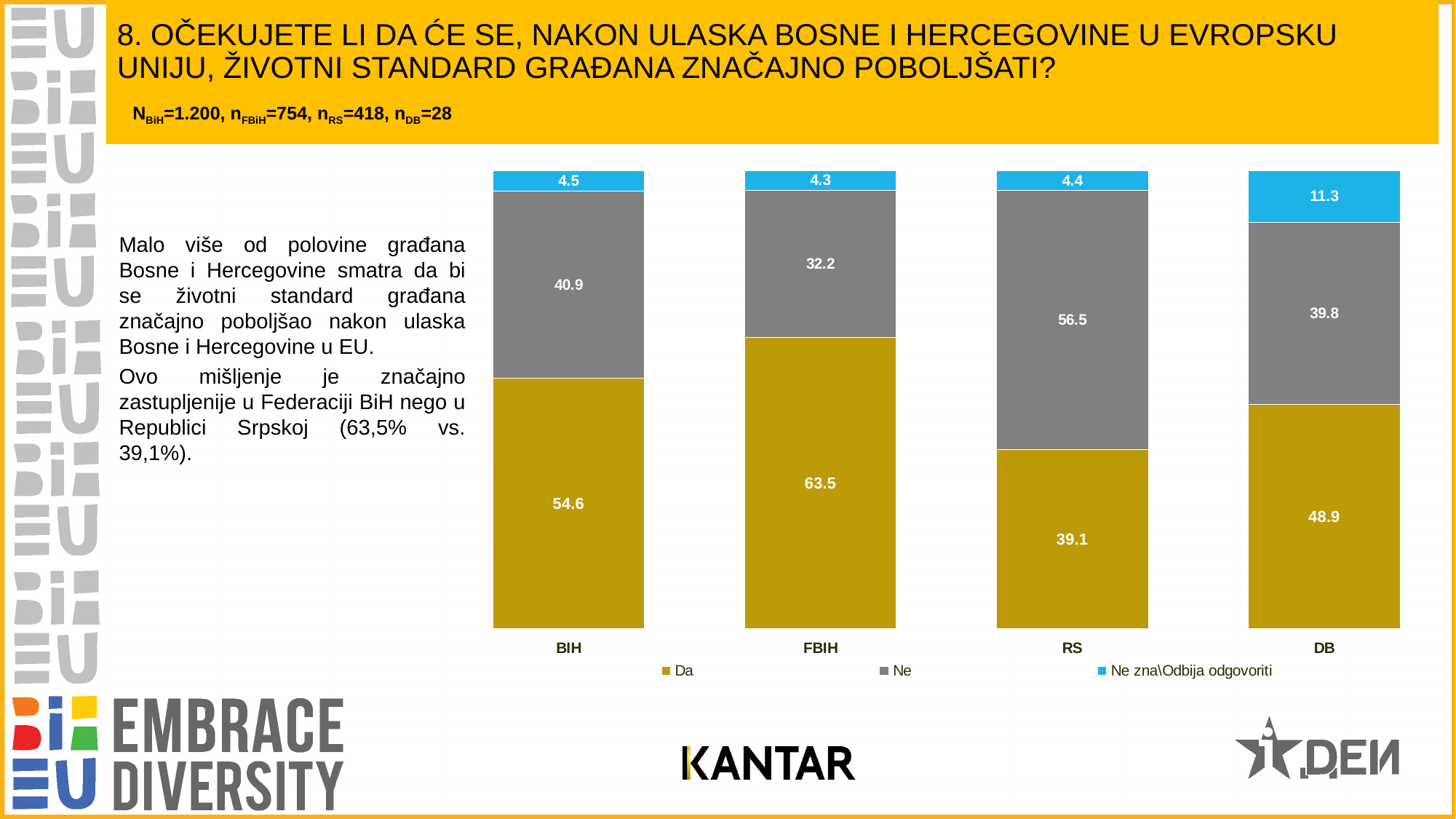
What is the value of "Da" for BIH? 54.6 What is the value of "Ne" for RS? 56.5 How many series does the legend list? 3 Which is larger, the "Ne" value for BIH or the "Ne" value for DB? BIH What is the value of "Ne zna\Odbija odgovoriti" for DB? 11.3 How many categories are shown on the x axis? 4 What is the value of "Da" for FBIH? 63.5 Which category has the lowest "Da" value? RS What is the total of the stacked bar for DB? 100.0 What is the difference between the "Da" values for FBIH and RS? 24.4 What kind of chart is shown on the slide? Stacked bar chart Which category has the highest "Da" value? FBIH